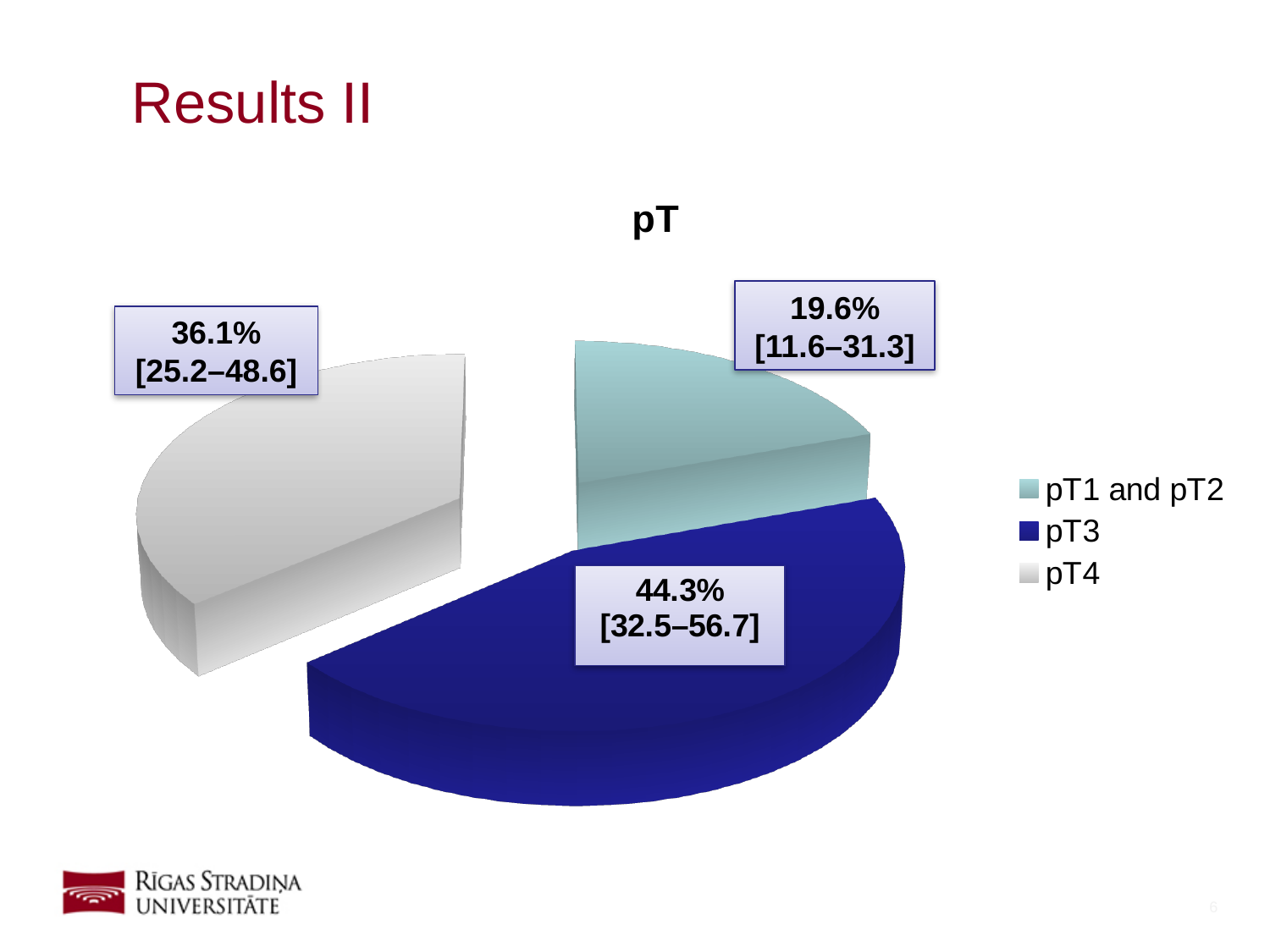
How many slices does the pie chart have? 3 Which is larger, the share for pT4 or the share for pT1 and pT2? pT4 What percentage share does the pT1 and pT2 slice have? 19.6% Which category has the largest share of the pie? pT3 What is the difference in percentage points between the pT3 and pT4 shares? 8.2 What is the title of the chart? pT What type of chart is shown on the slide? pie chart What confidence interval is shown in the label for the pT3 slice? [32.5–56.7] Which category has the smallest share of the pie? pT1 and pT2 What percentage share does pT4 have in the pie chart? 36.1% What percentage share does pT3 have in the pie chart? 44.3% How many entries does the legend list? 3